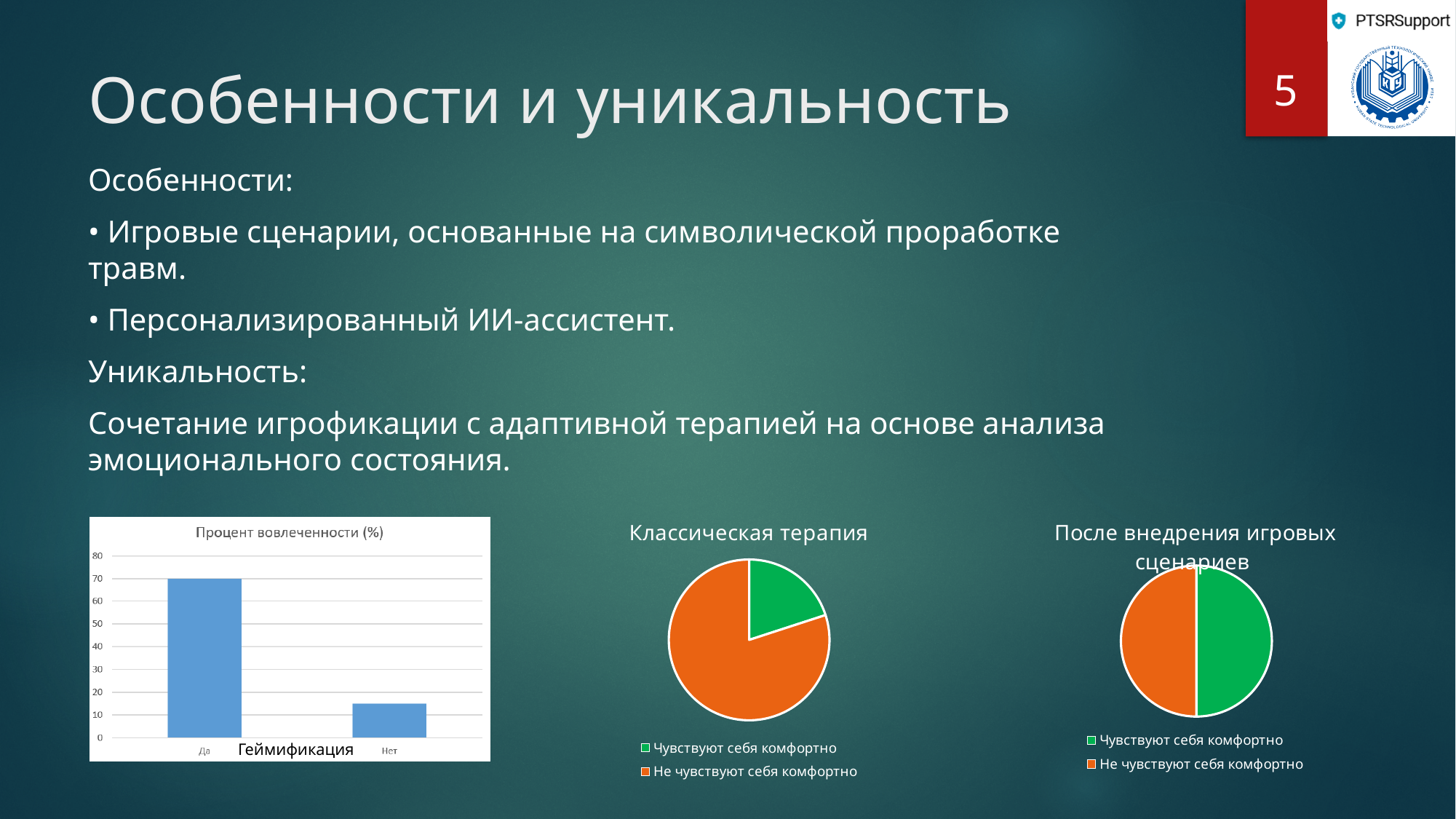
In the chart titled "Процент вовлеченности (%)", which category has the lowest value? Нет In the chart titled "Процент вовлеченности (%)", is the value for "Нет" greater or less than 10? greater In the chart titled "Процент вовлеченности (%)", what is the value for "Да"? 70 In the chart titled "Процент вовлеченности (%)", is the value for "Нет" greater or less than 20? less In the chart titled "Классическая терапия", which slice is larger: "Чувствуют себя комфортно" or "Не чувствуют себя комфортно"? Не чувствуют себя комфортно How many categories are shown in the chart titled "Процент вовлеченности (%)"? 2 In the chart titled "Процент вовлеченности (%)", which category has the highest value? Да What kind of chart is the chart titled "Процент вовлеченности (%)"? bar chart In the chart titled "Классическая терапия", what colour is the slice for "Чувствуют себя комфортно"? green What kind of chart is the chart titled "Классическая терапия"? pie chart How many entries does the legend list in the chart titled "После внедрения игровых сценариев"? 2 What is the label on the x axis of the chart titled "Процент вовлеченности (%)"? Геймификация